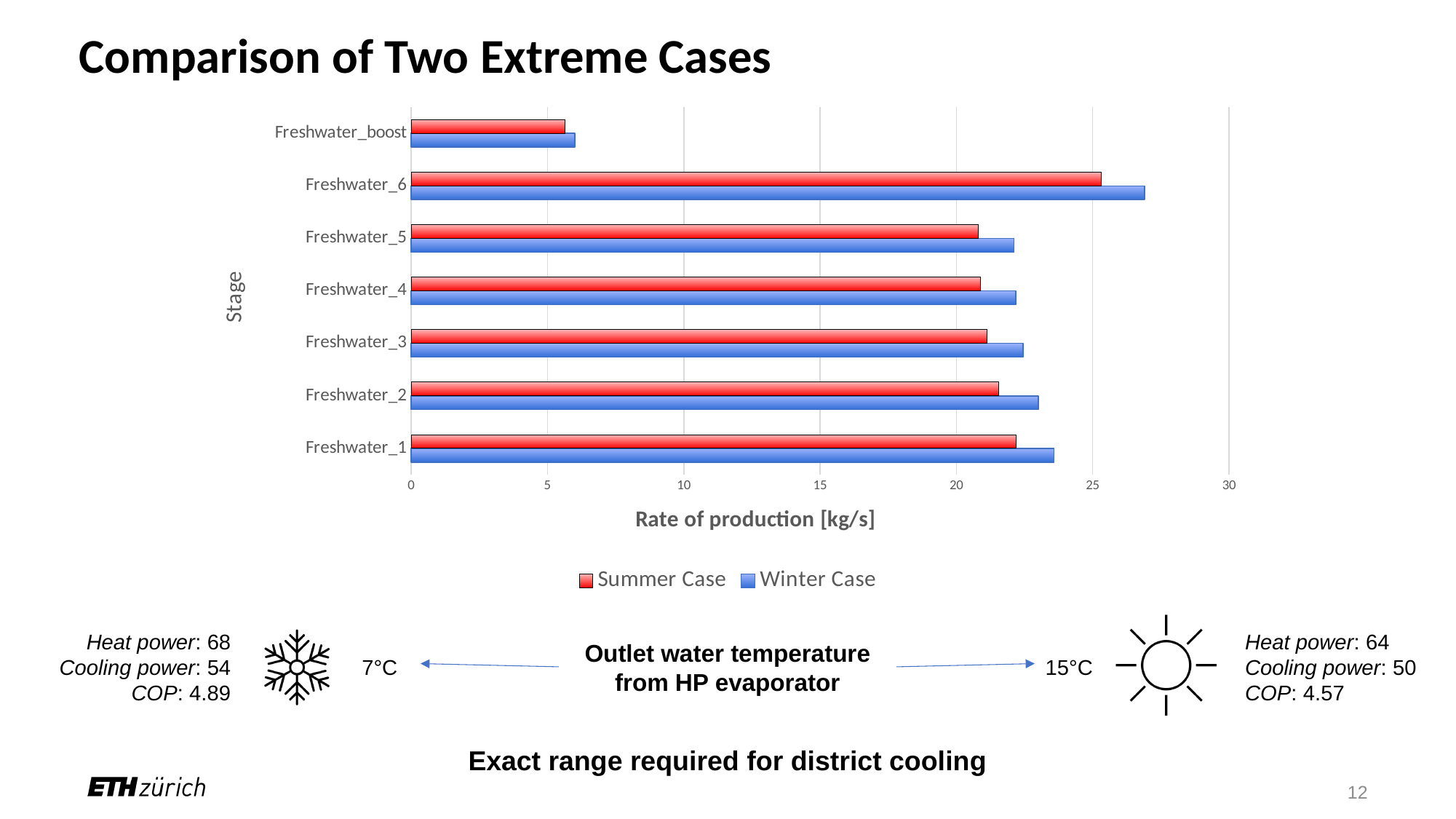
For Freshwater_1, which series has the larger rate of production, Summer Case or Winter Case? Winter Case Which stage has the lowest rate of production for the Summer Case? Freshwater_boost How many series does the legend list? 2 What is the title of the x axis? Rate of production [kg/s] What kind of chart is shown on the slide? bar chart Which stage has the highest rate of production for the Winter Case? Freshwater_6 How many stages are plotted on the y axis? 7 Which colour represents the Summer Case in the chart? red Is the Summer Case value for Freshwater_boost greater or less than 10? less Is the Summer Case value for Freshwater_1 greater or less than 20? greater Is the Winter Case value for Freshwater_6 greater or less than 25? greater For Freshwater_6, which series has the larger rate of production, Summer Case or Winter Case? Winter Case